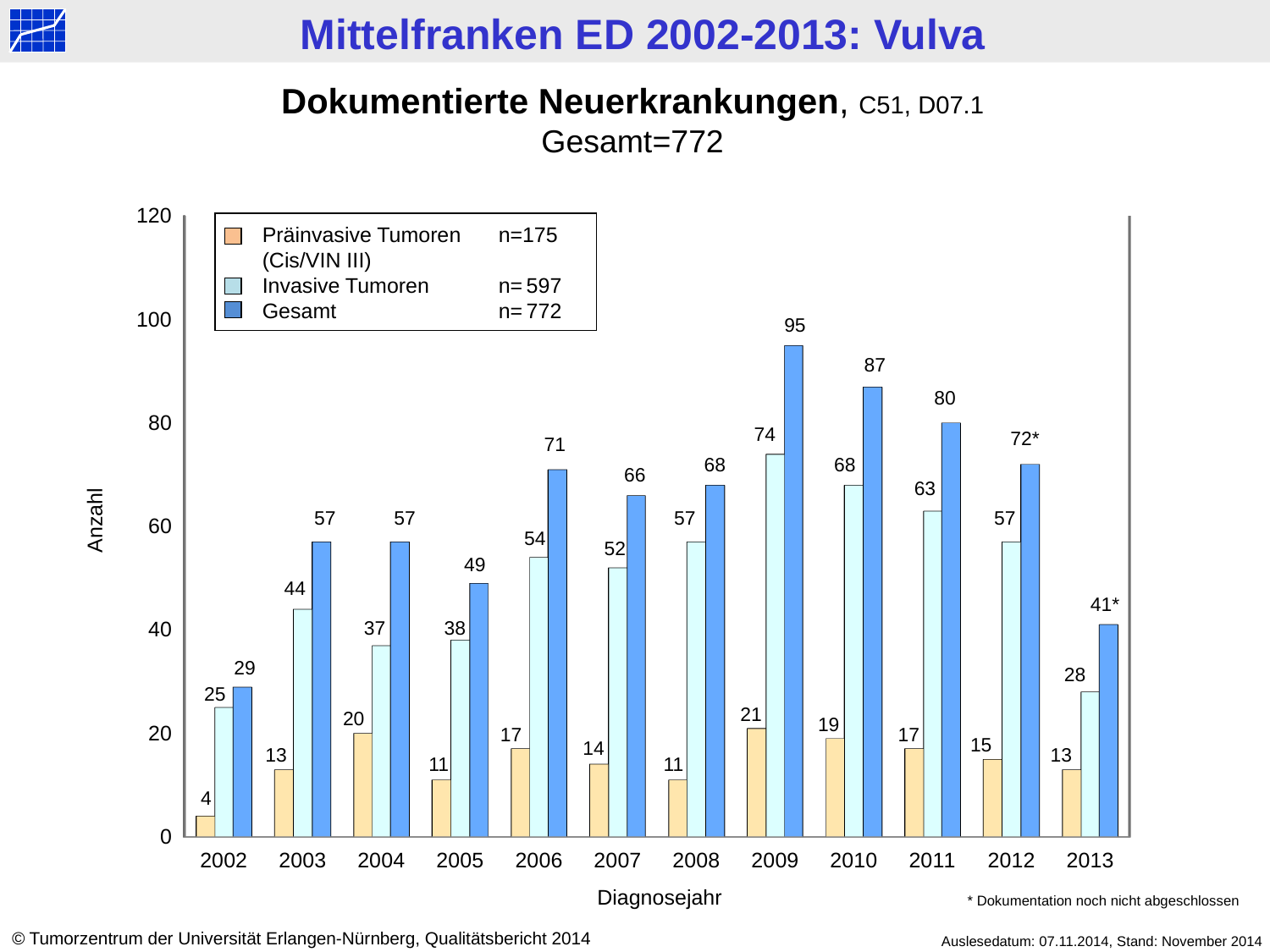
Which year has the lowest Gesamt value? 2002 How many series does the legend list? 3 What is the n value given in the legend for Invasive Tumoren? n=597 How many years are shown on the x axis? 12 Does the Gesamt value rise or fall from 2009 to 2013? fall Which year has the highest Gesamt value? 2009 What kind of chart is shown on the slide? bar chart What is the Gesamt value for 2009? 95 Which is larger, the Invasive Tumoren value for 2004 or for 2005? 2005 What is the value for Invasive Tumoren in 2006? 54 What is the value for Präinvasive Tumoren (Cis/VIN III) in 2002? 4 What is the difference between the Gesamt values for 2010 and 2011? 7